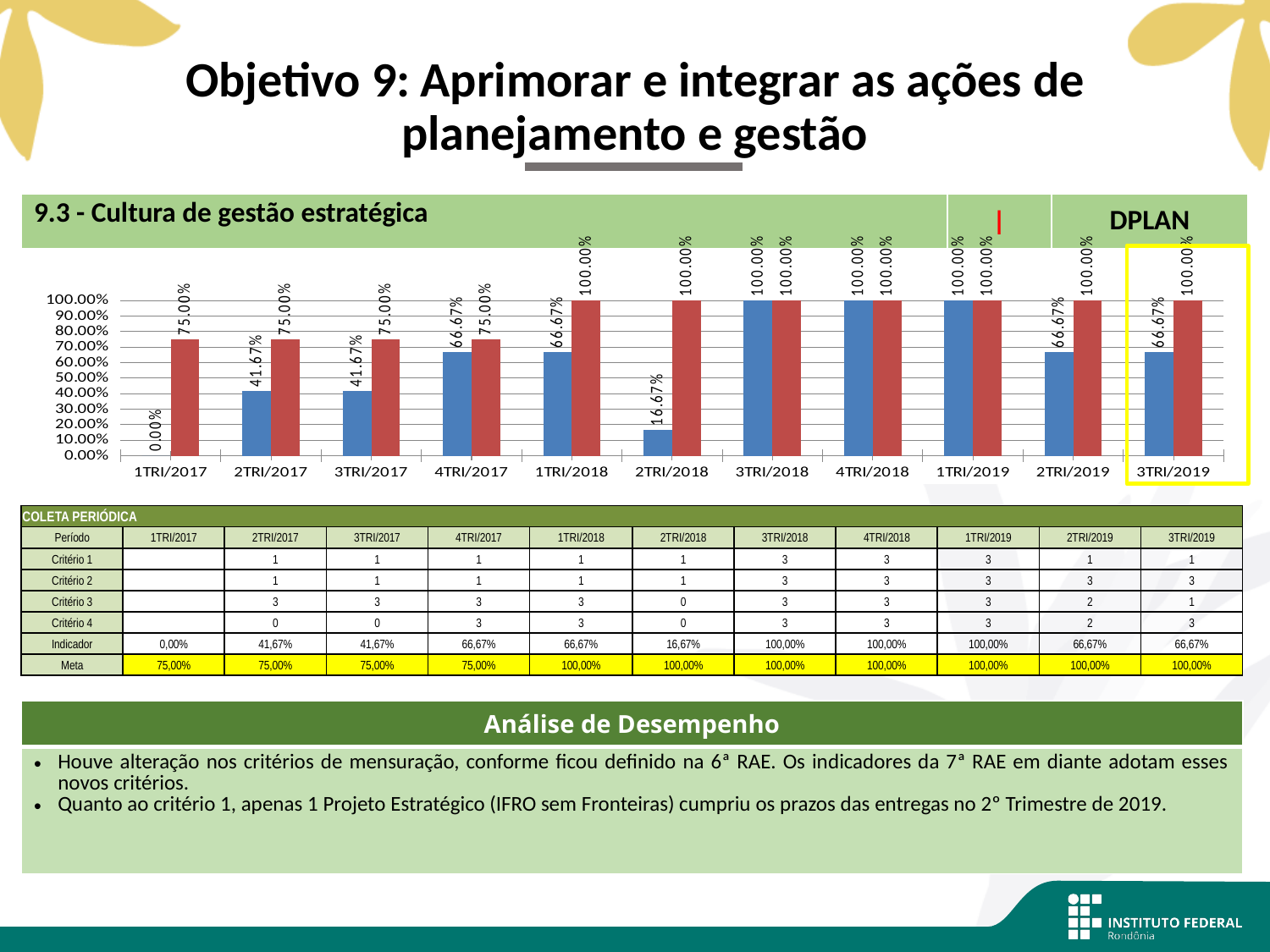
What kind of chart is shown on the slide? bar chart What is the value of the blue bar for 1TRI/2017? 0.00% How many periods are shown on the x axis of the chart? 11 Which is larger: the blue bar for 4TRI/2017 or the blue bar for 2TRI/2018? 4TRI/2017 What is the difference between the red bar and the blue bar for 2TRI/2018? 83.33% What is the difference between the red bar and the blue bar for 4TRI/2017? 8.33% What is the value of the red bar for 1TRI/2018? 100.00% Which period has the lowest blue bar? 1TRI/2017 Is the value of the blue bar for 2TRI/2019 greater or less than 50.00%? greater What is the value of the blue bar for 2TRI/2018? 16.67% Do the red bars rise or fall from 1TRI/2017 to 3TRI/2019? rise What is the value of the blue bar for 2TRI/2017? 41.67%